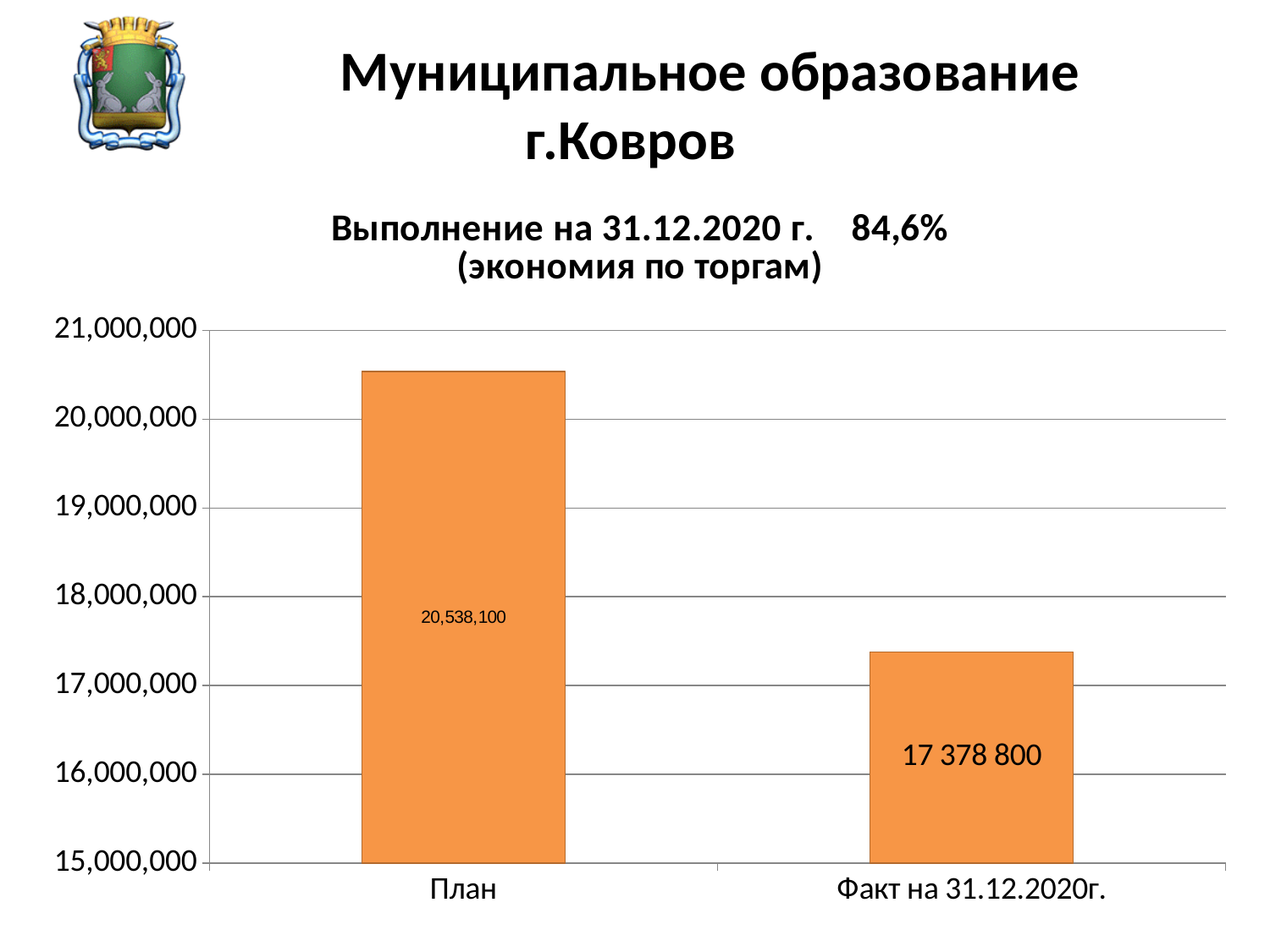
What percentage of execution (Выполнение) is stated in the chart title? 84,6% What is the value of the bar labelled Факт на 31.12.2020г.? 17 378 800 Do the values rise or fall from План to Факт на 31.12.2020г.? fall What type of chart is shown on the slide? bar chart How many bars are shown on the chart? 2 What is the value of the План bar? 20,538,100 Is the value for План greater or less than 20,000,000? greater What is the lowest value shown on the vertical axis? 15,000,000 Is the value for Факт на 31.12.2020г. greater or less than 18,000,000? less Which category has the higher value, План or Факт на 31.12.2020г.? План What is the difference between the План value and the Факт на 31.12.2020г. value? 3,159,300 Which category has the lowest value on the chart? Факт на 31.12.2020г.